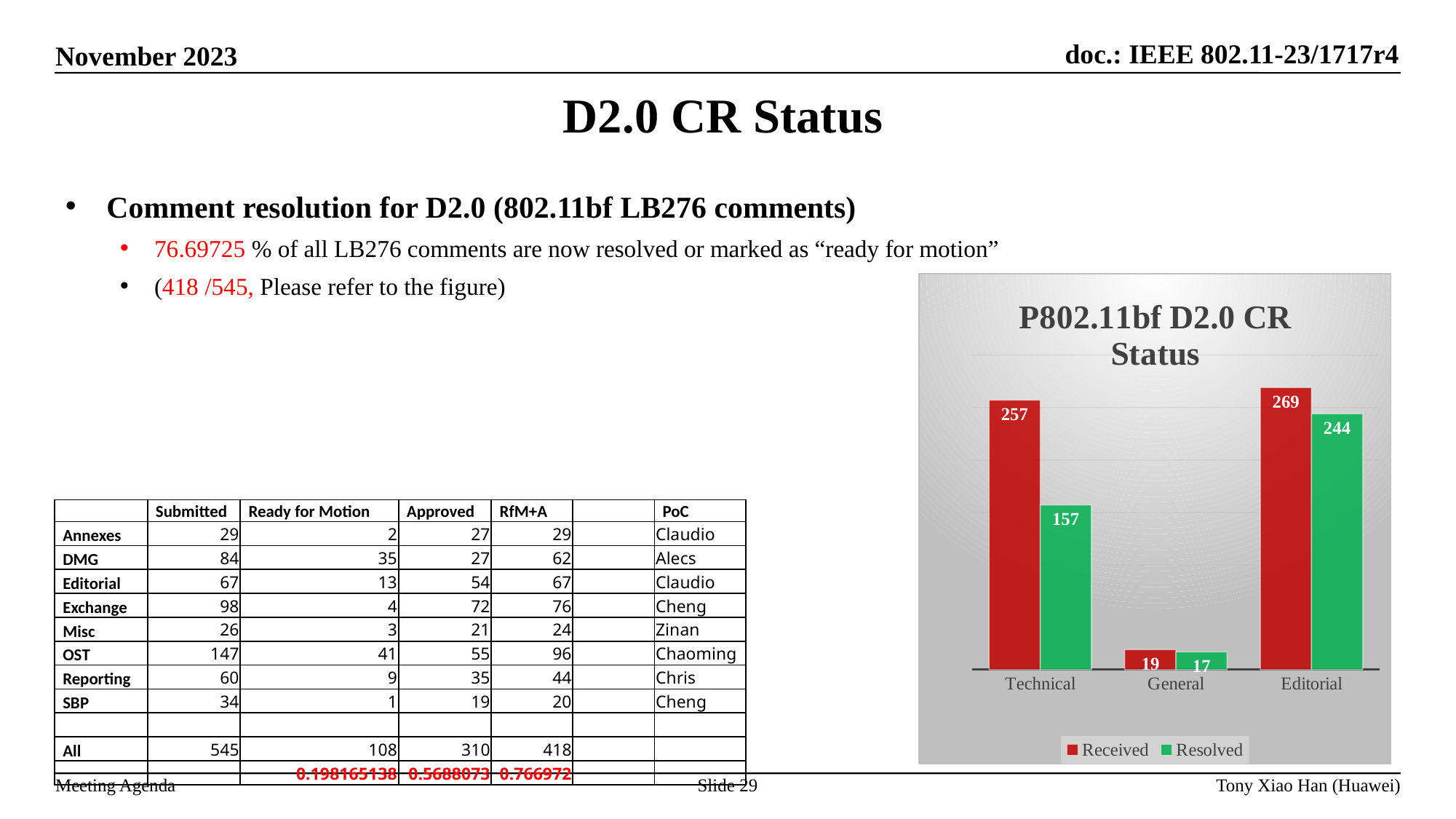
What is the Resolved value for Editorial in the P802.11bf D2.0 CR Status chart? 244 What kind of chart is the P802.11bf D2.0 CR Status chart? bar chart Which category has the lowest Resolved value in the P802.11bf D2.0 CR Status chart? General Which category has the highest Received value in the P802.11bf D2.0 CR Status chart? Editorial Is the Resolved value for Technical or the Resolved value for Editorial larger in the P802.11bf D2.0 CR Status chart? Editorial How many categories are shown on the x axis of the P802.11bf D2.0 CR Status chart? 3 What colour are the Resolved bars in the P802.11bf D2.0 CR Status chart? green What is the Received value for Technical in the P802.11bf D2.0 CR Status chart? 257 How many series does the legend of the P802.11bf D2.0 CR Status chart list? 2 What is the Received value for General in the P802.11bf D2.0 CR Status chart? 19 What is the difference between Received and Resolved for Technical in the P802.11bf D2.0 CR Status chart? 100 What is the difference between Received and Resolved for Editorial in the P802.11bf D2.0 CR Status chart? 25